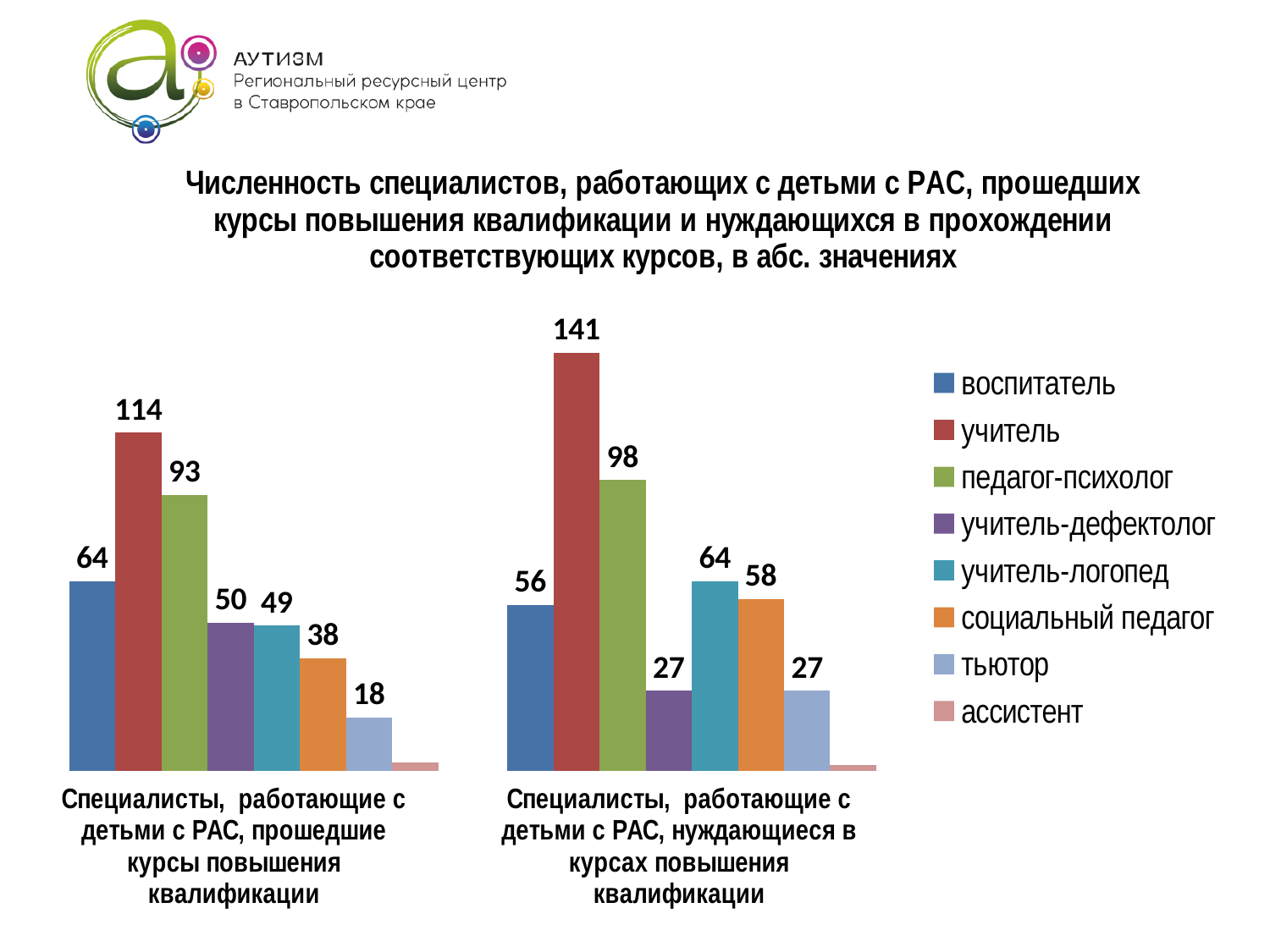
What is the value for педагог-психолог among specialists who need professional development courses (нуждающиеся в курсах повышения квалификации)? 98 What kind of chart is shown on the slide? bar chart How many series does the legend list? 8 Which series has the highest value among specialists who need professional development courses? учитель What is the difference between the учитель values for specialists needing courses (141) and specialists who completed courses (114)? 27 How many category groups are shown on the x axis? 2 What is the value for социальный педагог among specialists who need professional development courses? 58 Which is larger: the учитель-логопед value for specialists who completed courses or for specialists who need courses? specialists who need courses (64) What is the value for учитель among specialists who have completed professional development courses (прошедшие курсы повышения квалификации)? 114 What colour represents учитель in the legend? red What is the value for тьютор among specialists who have completed professional development courses? 18 Which labelled series has the lowest value among specialists who have completed professional development courses? тьютор